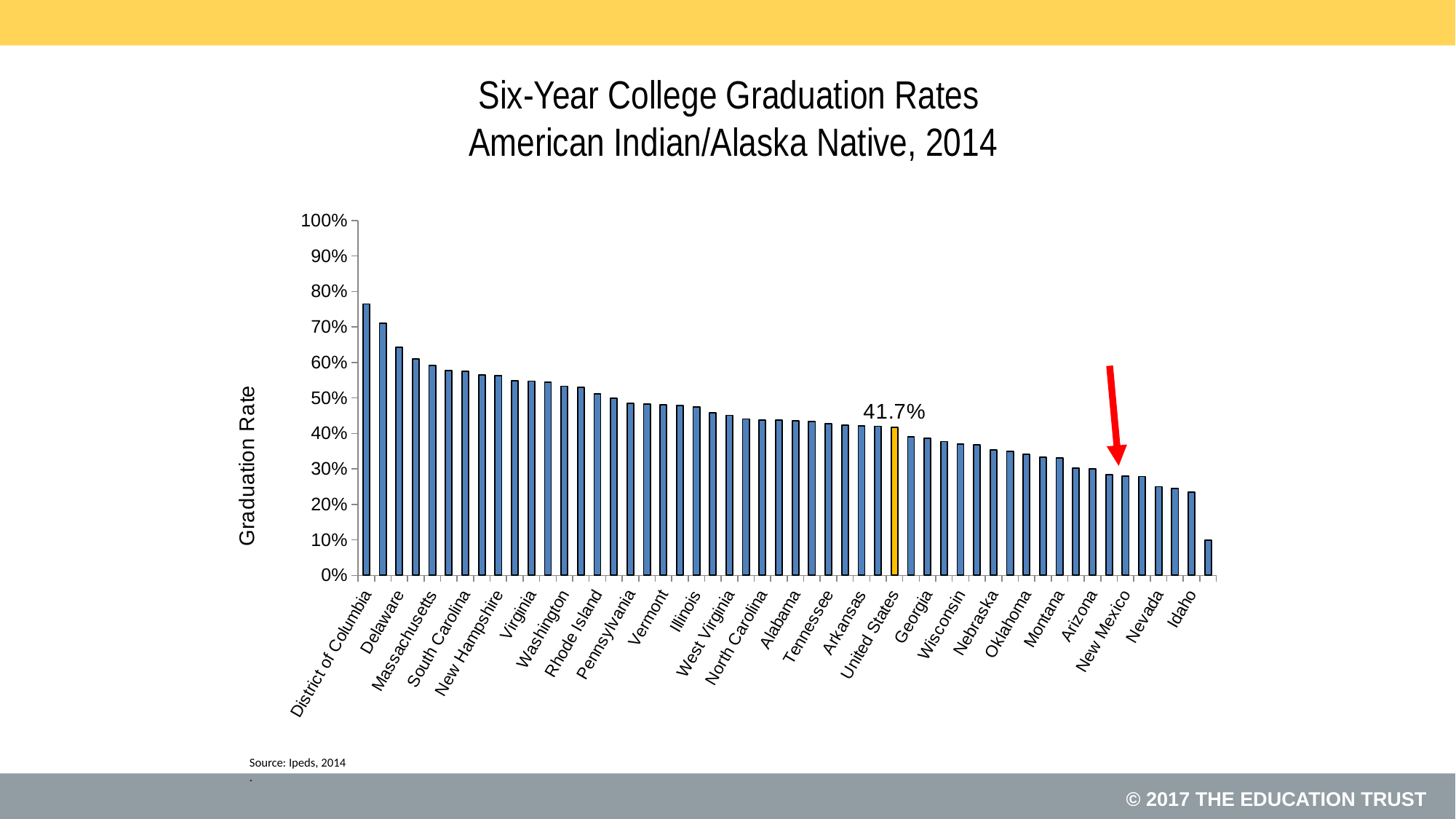
What kind of chart is shown on the slide? bar chart Which bar is highlighted in a different colour (orange) from the rest? United States Which has a higher graduation rate, Georgia or Delaware? Delaware What is the label on the vertical axis? Graduation Rate Do the values rise or fall moving from left to right along the x axis? fall Which category has the highest graduation rate? District of Columbia Is the value for United States greater or less than 50%? less Which has a higher graduation rate, District of Columbia or Idaho? District of Columbia What is the six-year graduation rate shown for the United States? 41.7% Is the value for District of Columbia greater or less than 70%? greater Is the value for Idaho greater or less than 30%? less